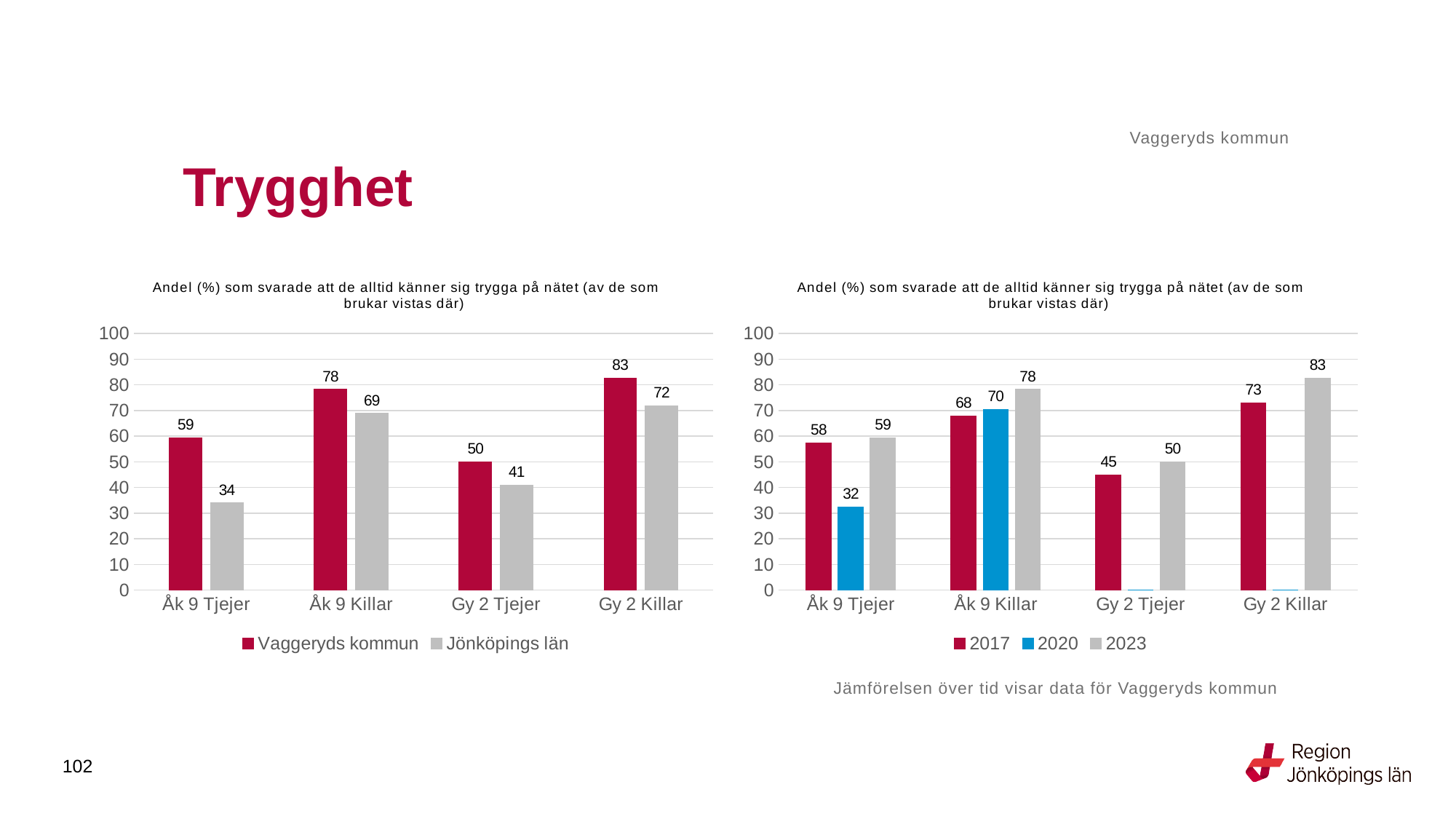
In the right chart, which is larger for Åk 9 Killar: 2017 or 2023? 2023 What kind of chart is the right chart? Bar chart In the right chart, how many series does the legend list? 3 In the left chart, which category has the lowest value for Jönköpings län? Åk 9 Tjejer In the left chart, what is the difference between Vaggeryds kommun and Jönköpings län for Åk 9 Tjejer? 25 In the right chart, what is the value for 2020 for Åk 9 Tjejer? 32 In the left chart, what is the value for Vaggeryds kommun for Åk 9 Tjejer? 59 In the right chart, what is the difference between 2023 and 2017 for Gy 2 Killar? 10 In the left chart, how many series does the legend list? 2 In the left chart, what is the value for Jönköpings län for Gy 2 Tjejer? 41 In the left chart, which category has the highest value for Vaggeryds kommun? Gy 2 Killar In the right chart, what is the value for 2023 for Gy 2 Killar? 83